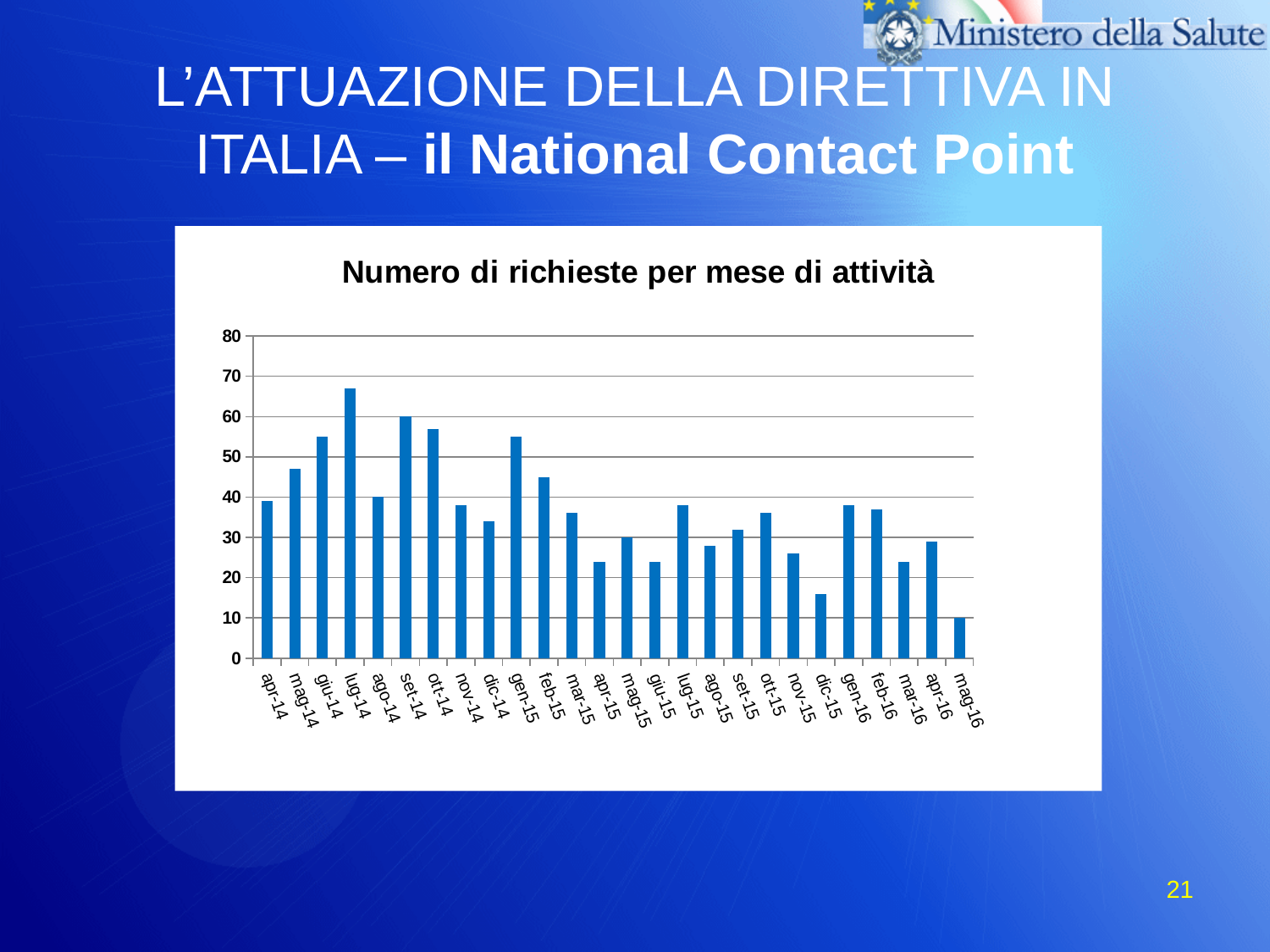
Is the value for apr-15 greater or less than 30? less Is the value for dic-15 greater or less than 20? less What kind of chart is shown on the slide? bar chart Which month has the lowest number of requests? mag-16 Which month has the highest number of requests? lug-14 Which is larger, the value for feb-15 or the value for dic-15? feb-15 From apr-14 to lug-14, do the values rise or fall? rise How many months (bars) are plotted in the chart? 26 Which is larger, the value for giu-14 or the value for dic-14? giu-14 What is the title of the chart? Numero di richieste per mese di attività Is the value for lug-14 greater or less than 60? greater